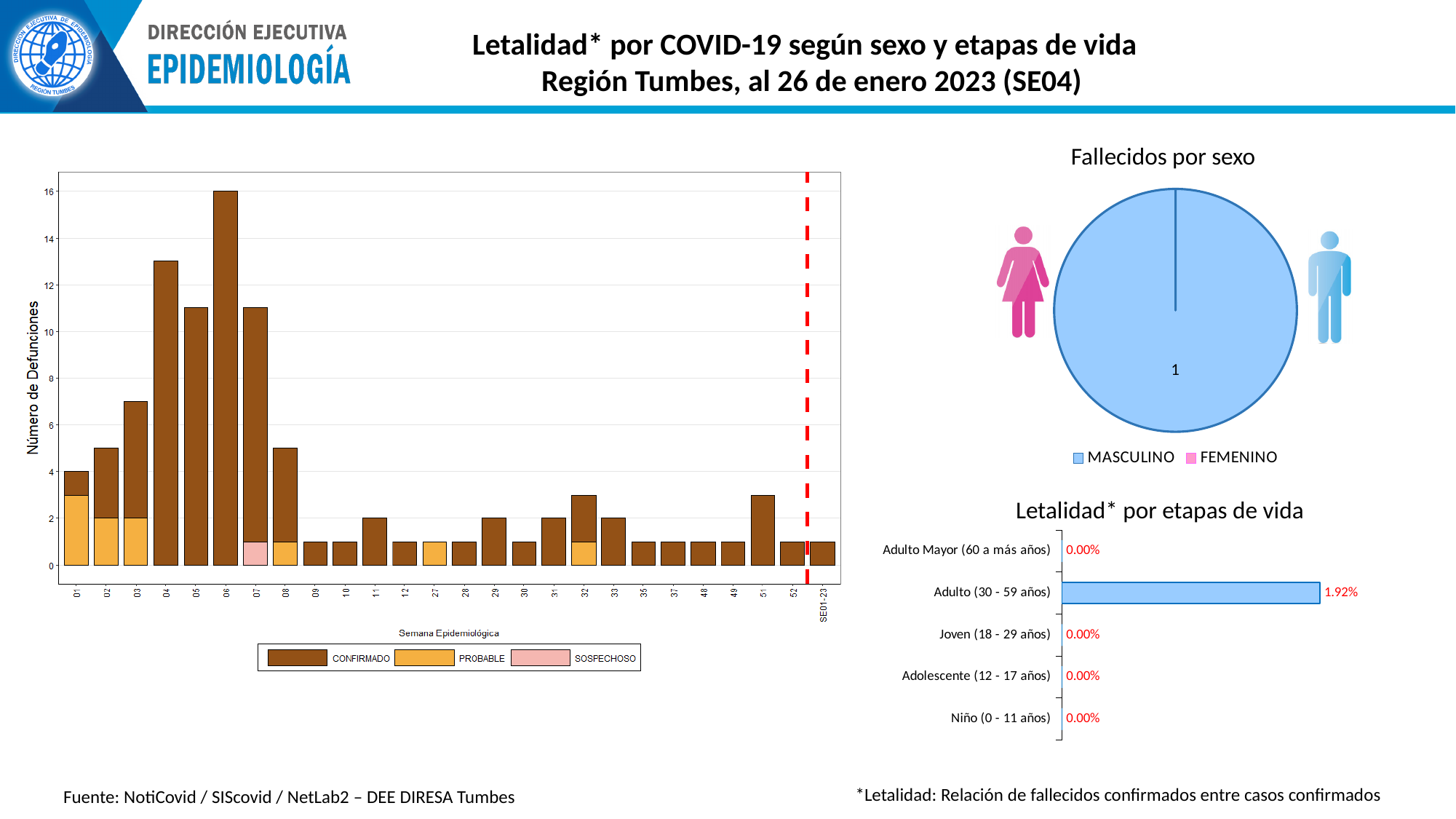
In the 'Letalidad* por etapas de vida' chart, which age group has the highest letalidad? Adulto (30 - 59 años) In the 'Número de Defunciones' bar chart on the left, what is the total number of deaths in semana 06? 16 In the 'Fallecidos por sexo' chart, what value is labelled on the MASCULINO slice? 1 In the 'Número de Defunciones' bar chart on the left, which has more deaths, semana 05 or semana 08? 05 In the 'Letalidad* por etapas de vida' chart, what is the value for Adulto (30 - 59 años)? 1.92% How many series does the legend of the 'Número de Defunciones' bar chart on the left list? 3 In the 'Número de Defunciones' bar chart on the left, which semana epidemiológica has the highest number of deaths? 06 What kind of chart is 'Fallecidos por sexo'? Pie chart In the 'Letalidad* por etapas de vida' chart, what is the value for Niño (0 - 11 años)? 0.00% How many age groups are shown in the 'Letalidad* por etapas de vida' chart? 5 In the 'Número de Defunciones' bar chart on the left, is the value for semana 04 greater or less than 12? greater How many series does the legend of the 'Fallecidos por sexo' chart list? 2